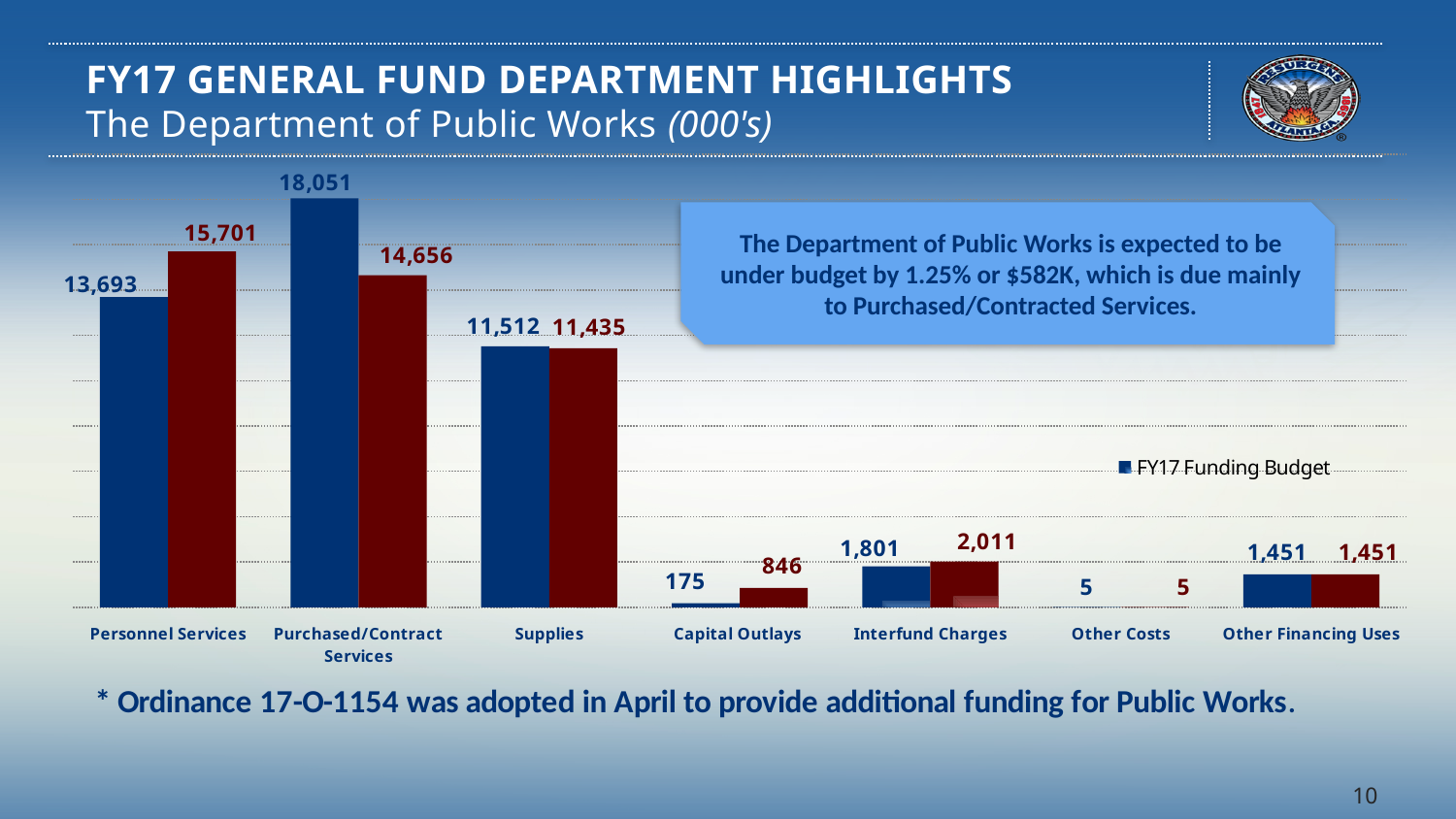
Which category has the lowest FY17 Funding Budget value? Other Costs Which category has the highest FY17 Funding Budget value? Purchased/Contract Services What legend entry is visible on the chart? FY17 Funding Budget What is the FY17 Funding Budget value for Personnel Services? 13,693 How many categories are shown on the x axis of the chart? 7 What is the difference between the FY17 Funding Budget and the red bar for Purchased/Contract Services? 3,395 What value does the red bar show for Interfund Charges? 2,011 What type of chart is shown on the slide? bar chart For Capital Outlays, which is larger: the FY17 Funding Budget bar or the red bar? the red bar What is the FY17 Funding Budget value for Purchased/Contract Services? 18,051 What value does the red bar show for Capital Outlays? 846 What is the difference between the red bar and the FY17 Funding Budget bar for Personnel Services? 2,008